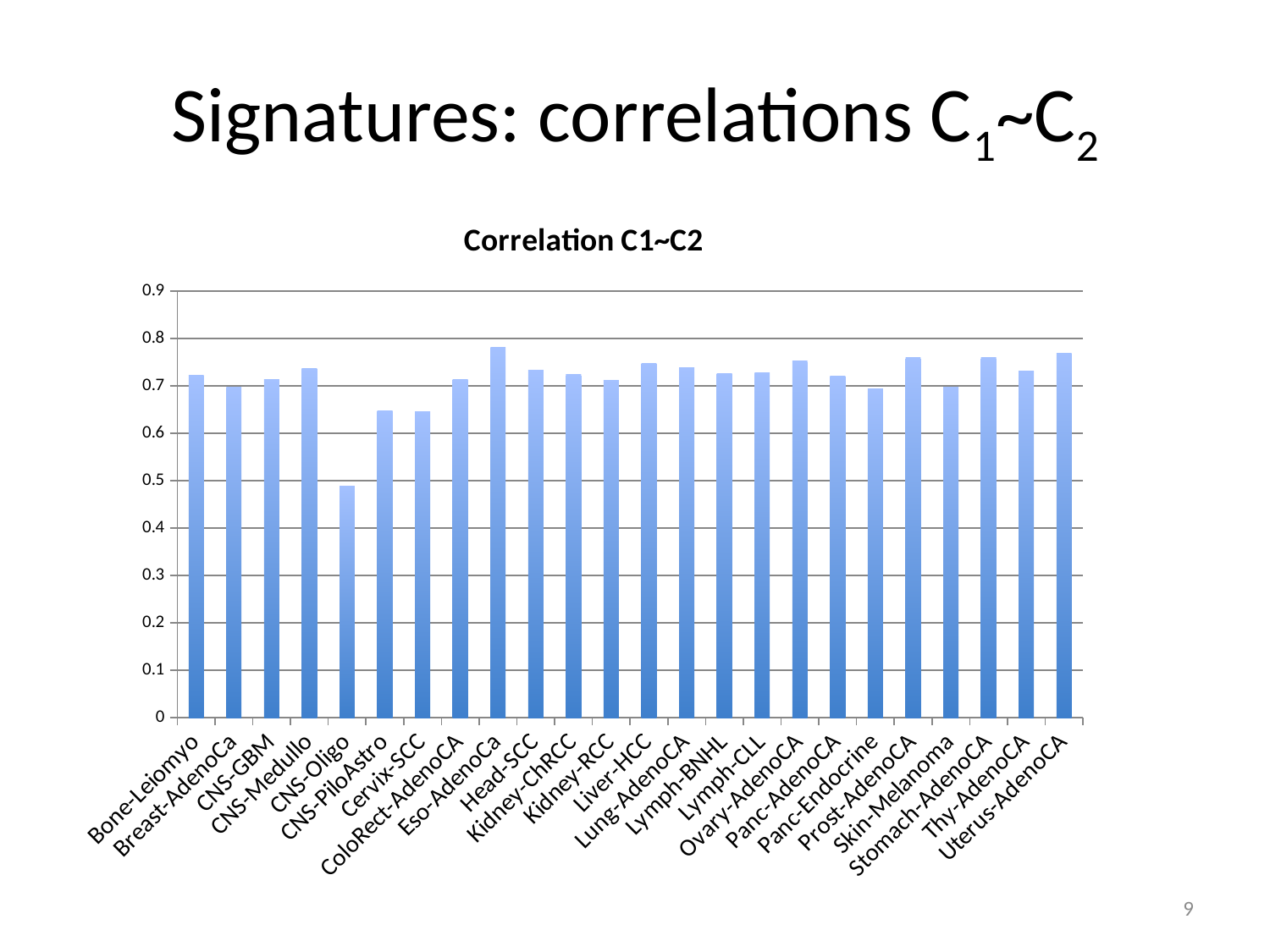
Is the value for Liver-HCC greater or less than 0.7? greater Which has the larger value, Eso-AdenoCa or CNS-PiloAstro? Eso-AdenoCa Is the value for CNS-Oligo greater or less than 0.5? less How many categories (bars) are plotted in the chart? 24 What is the title of the chart? Correlation C1~C2 Is the value for Cervix-SCC greater or less than 0.7? less Which category has the lowest correlation value? CNS-Oligo Which has the larger value, Cervix-SCC or Liver-HCC? Liver-HCC What kind of chart is shown on the slide? bar chart Which has the larger value, CNS-Oligo or CNS-Medullo? CNS-Medullo